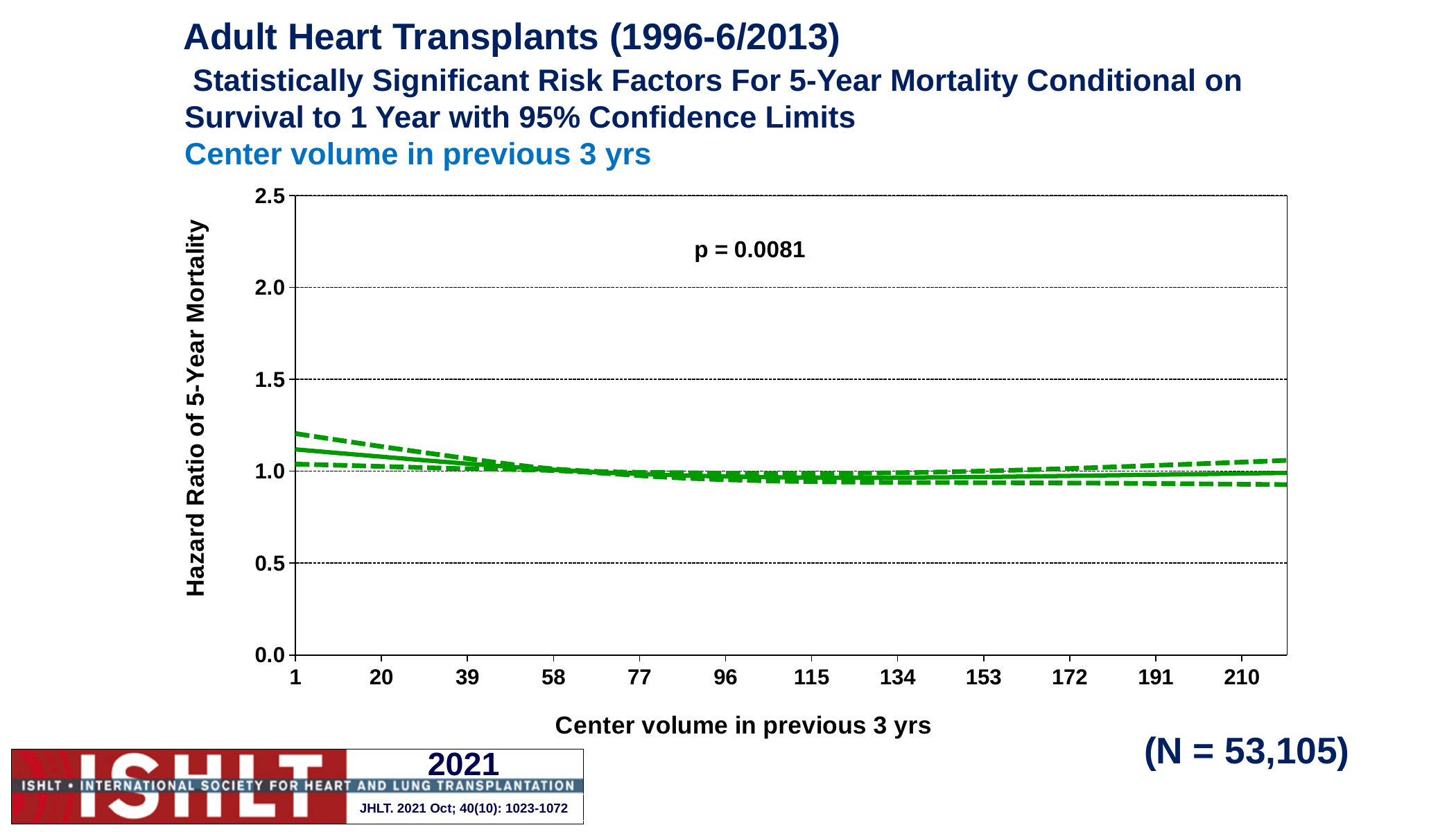
Is the hazard ratio (solid line) at a center volume of 1 greater or less than 1.0? greater What is the sample size (N) stated on the slide? N = 53,105 Is the upper confidence limit at a center volume of 1 greater or less than 1.5? less Does the hazard ratio (solid line) rise or fall as center volume increases from 1 to 58? fall How many tick labels are shown on the x-axis? 12 What is the p-value printed on the chart? p = 0.0081 What kind of chart is shown on the slide? line chart How many lines are plotted on the chart (solid and dashed)? 3 What is the label of the y-axis? Hazard Ratio of 5-Year Mortality Is the hazard ratio (solid line) at a center volume of 115 greater or less than 1.5? less